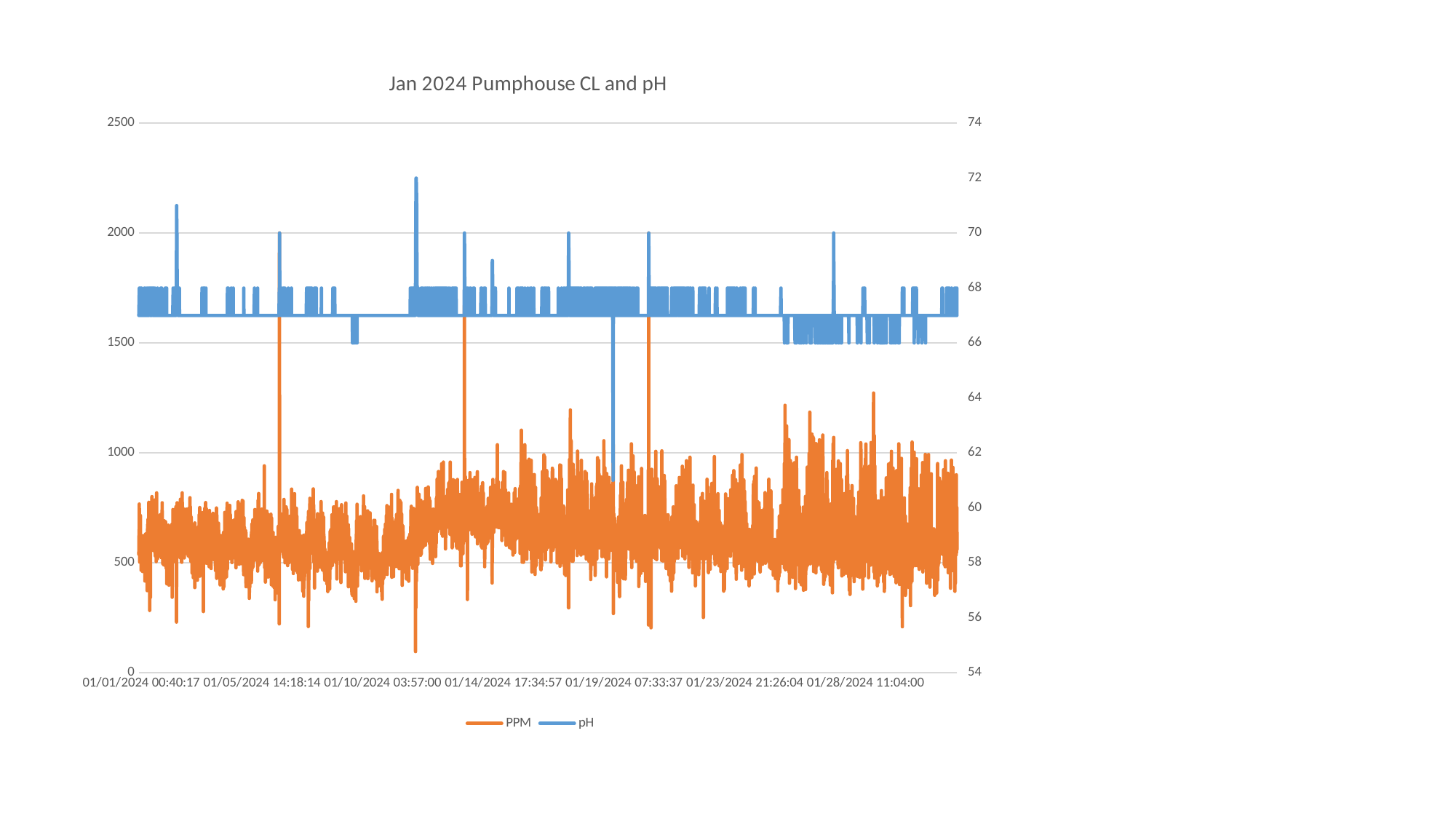
How many series does the legend list? 2 What is the title of the chart? Jan 2024 Pumphouse CL and pH Does the typical level of the PPM series rise or fall from the start of January to the end? rise Is the highest pH spike greater or less than 70 on the right axis? greater What kind of chart is shown on the slide? line chart Which series is drawn in orange? PPM Is the lowest pH dip greater or less than 64 on the right axis? less Is the highest PPM spike greater or less than 1000 on the left axis? greater